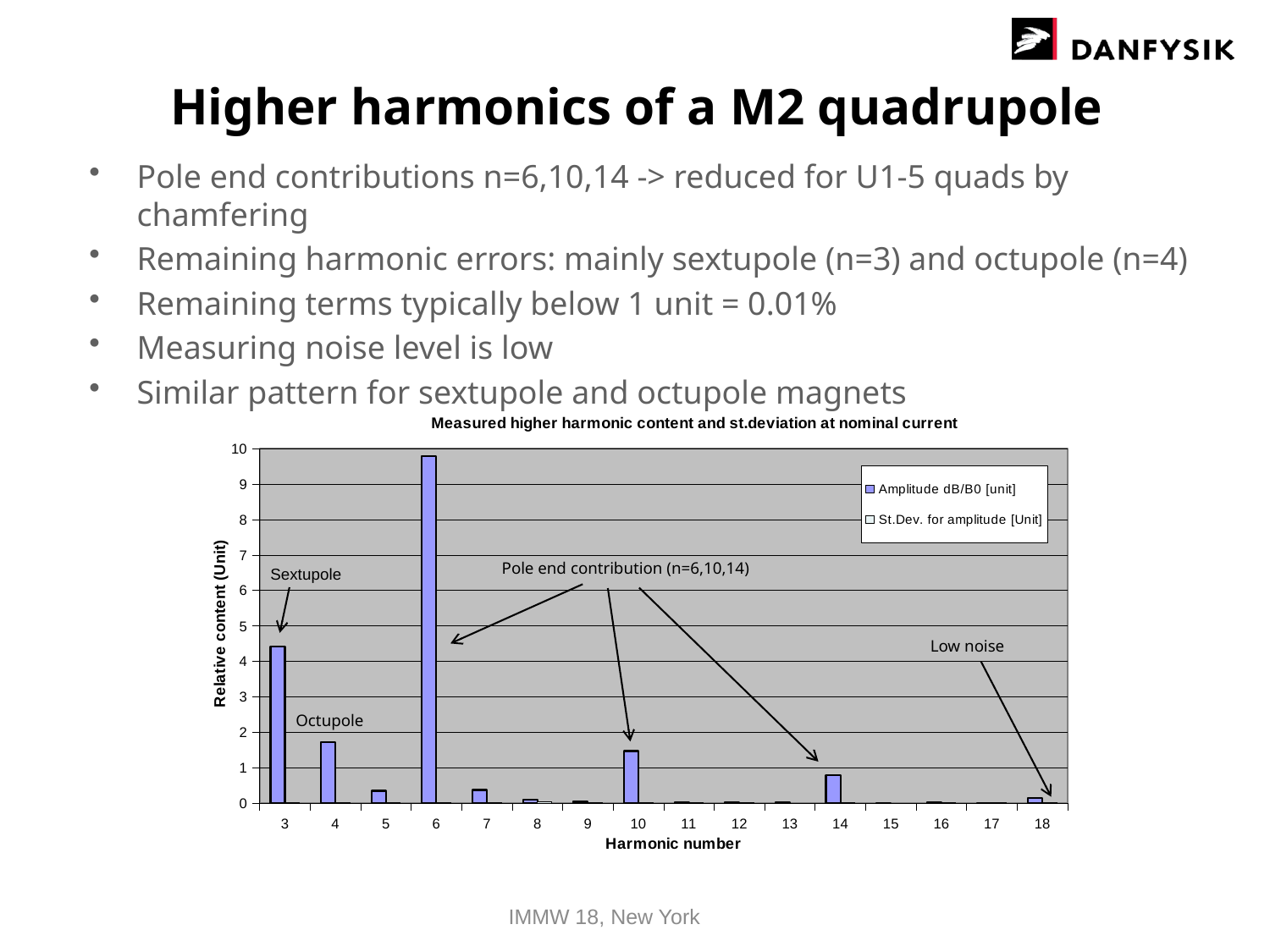
Is the amplitude for harmonic number 3 greater or less than 4? greater What is the label of the chart's y axis? Relative content (Unit) Is the amplitude for harmonic number 14 greater or less than 1? less Is the amplitude for harmonic number 10 greater or less than 1? greater Which has the larger amplitude, harmonic number 3 or harmonic number 4? 3 How many harmonic numbers are shown along the x axis of the chart? 16 Which harmonic number has the highest amplitude in the chart? 6 What is the title of the chart? Measured higher harmonic content and st.deviation at nominal current How many series does the chart legend list? 2 What kind of chart is shown on the slide? bar chart